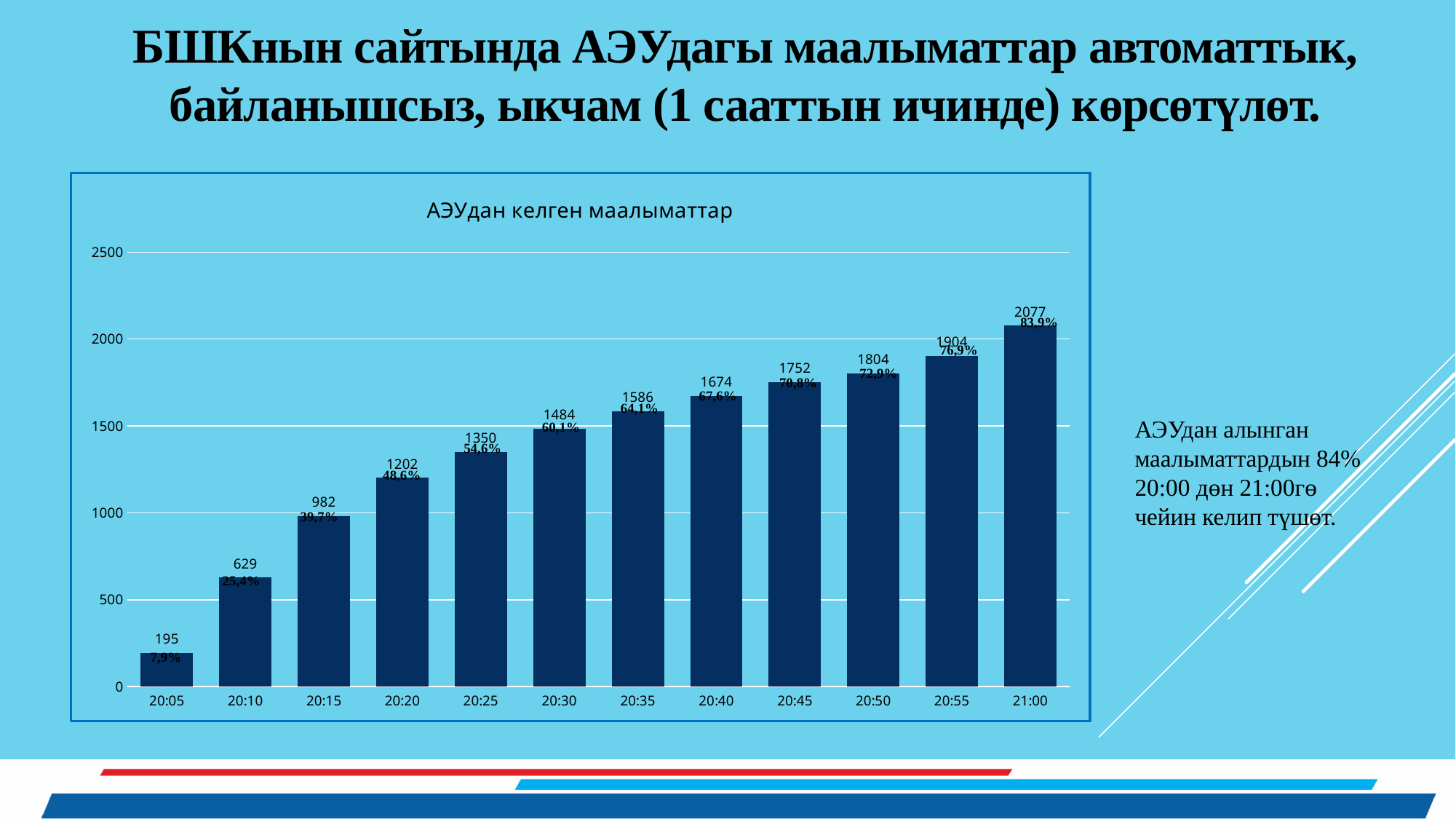
What is the value for 20:50? 1804 Is the value for 20:25 greater or less than 1500? less What is the value for 20:05? 195 Do the values rise or fall from 20:05 to 21:00? rise What is the difference between the values for 21:00 and 20:55? 173 Which is larger, the value for 20:20 or the value for 20:15? 20:20 What kind of chart is shown? bar chart How many time categories are shown on the x axis? 12 What is the difference between the values for 20:10 and 20:05? 434 Which time has the lowest value? 20:05 Which time has the highest value? 21:00 What is the value for 20:30? 1484